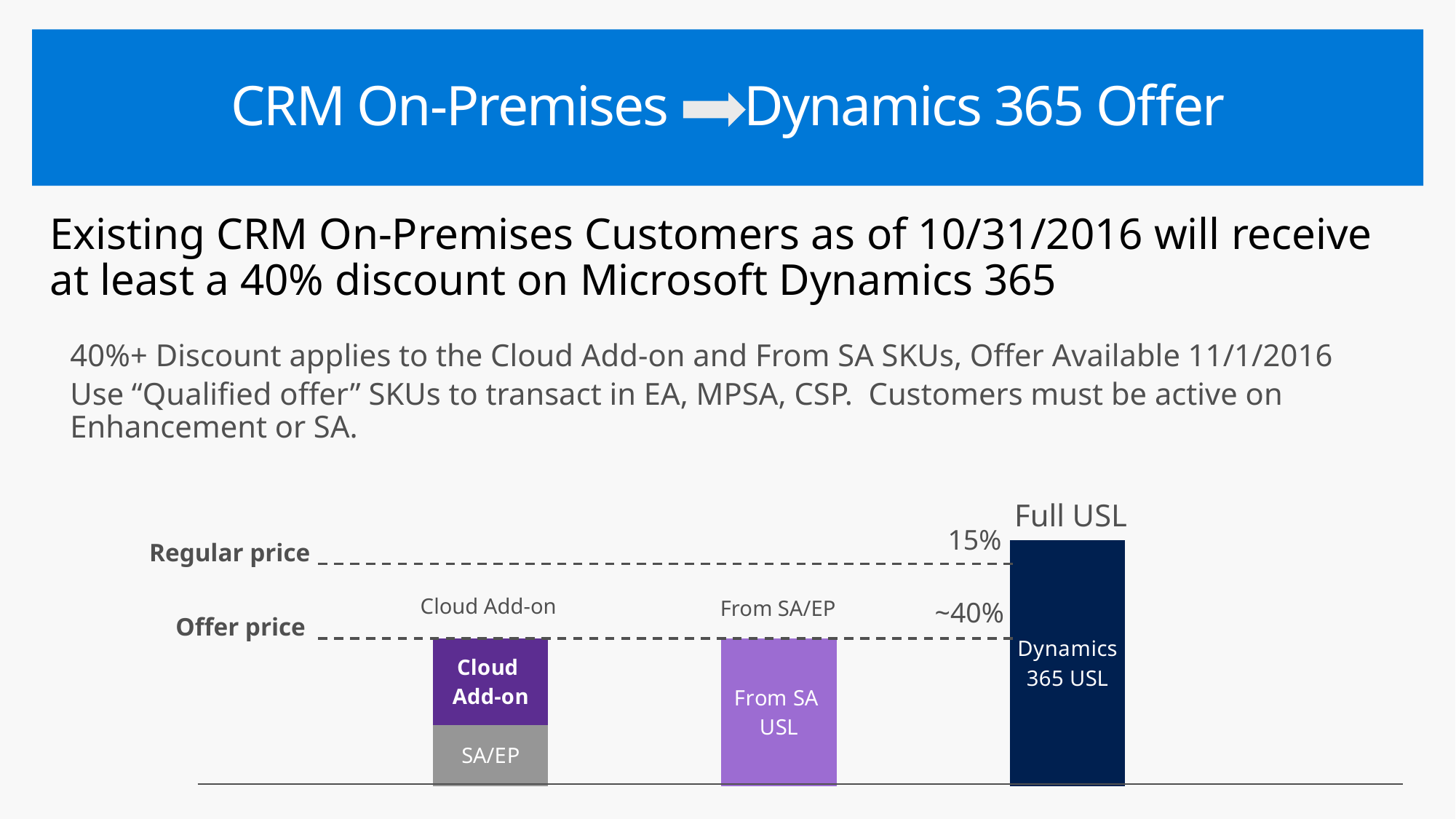
How many bars are plotted in the chart? 3 What label is printed inside the Full USL bar? Dynamics 365 USL What percentage label is printed above the Full USL bar next to the Regular price line? 15% What are the two segments of the Cloud Add-on bar labelled? Cloud Add-on and SA/EP Is the Cloud Add-on bar taller or shorter than the Full USL bar? shorter What label is printed inside the From SA/EP bar? From SA USL What kind of chart is shown at the bottom of the slide? bar chart Which bar in the chart is the tallest? Full USL Which two bars reach the Offer price dashed line? Cloud Add-on and From SA/EP Which bar reaches above the Regular price dashed line? Full USL Which bar is made up of two stacked segments? Cloud Add-on